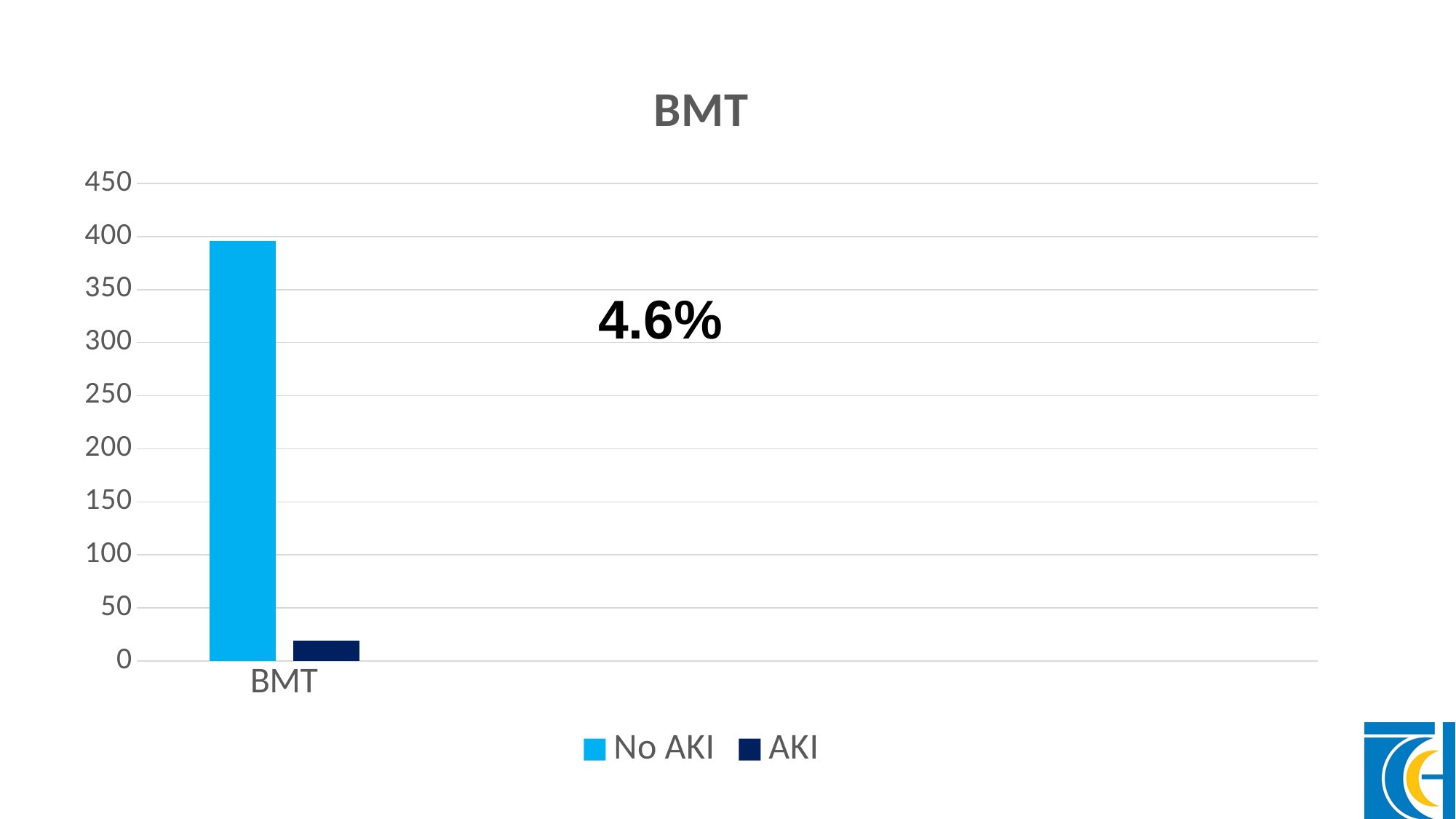
What percentage is printed as an annotation on the chart? 4.6% Is the value for AKI greater or less than 50? less How many series does the legend list? 2 How many categories are shown on the x axis? 1 Which series has the highest value for BMT? No AKI Is the value for No AKI greater or less than 350? greater Which series has the lowest value for BMT? AKI What is the highest value shown on the y axis? 450 What is the title of the chart? BMT What kind of chart is shown on the slide? bar chart Which series has the taller bar for BMT, No AKI or AKI? No AKI